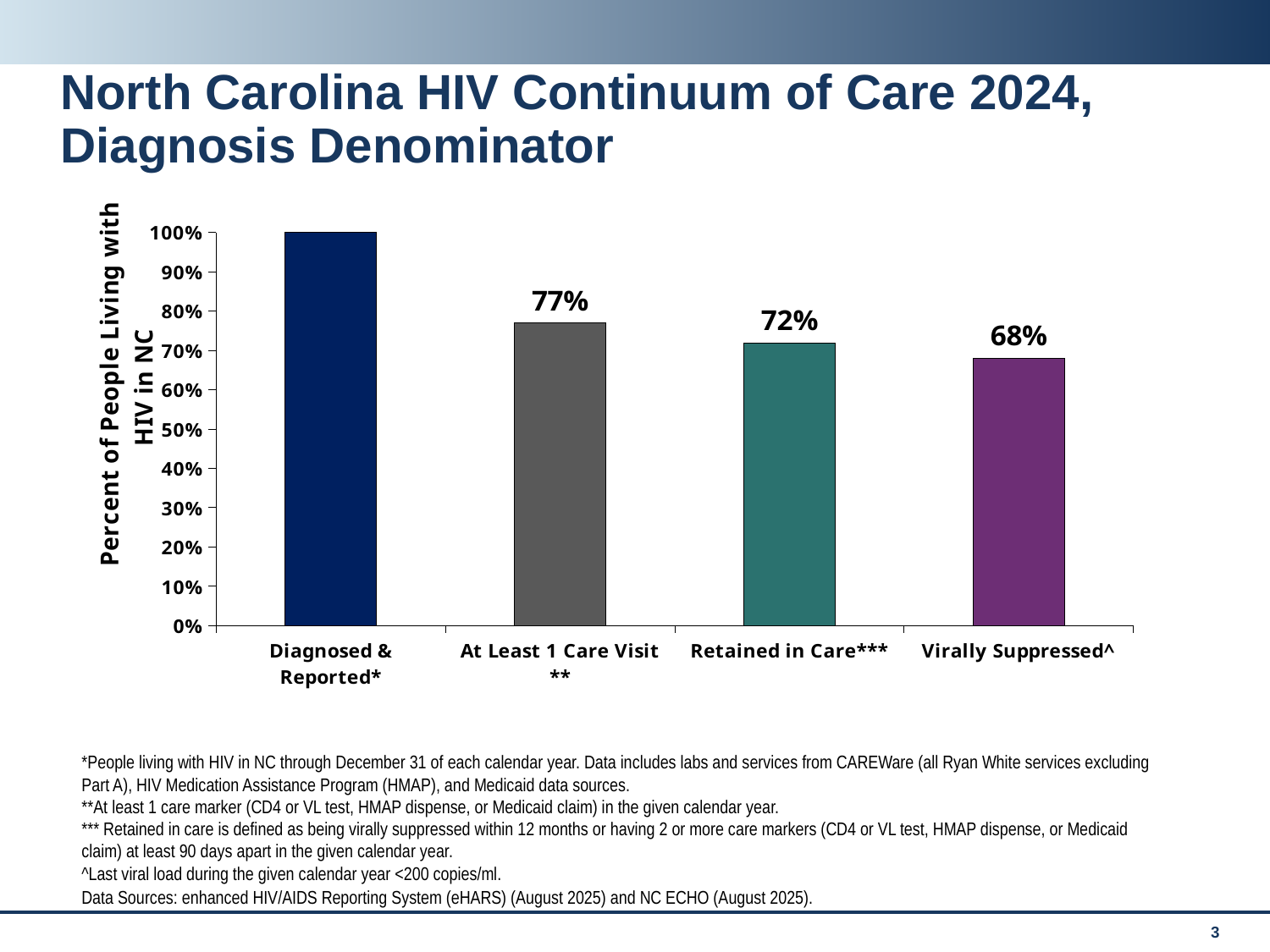
Which category has the lowest value? Virally Suppressed^ What is the value for Virally Suppressed^? 68% What kind of chart is shown on the slide? Bar chart Which category has the highest value? Diagnosed & Reported* What is the value for Retained in Care***? 72% What is the difference between the values for Retained in Care*** and Virally Suppressed^? 4% What is the value for Diagnosed & Reported*? 100% What is the difference between the values for At Least 1 Care Visit** and Virally Suppressed^? 9% How many categories are shown on the x axis? 4 What is the value for At Least 1 Care Visit**? 77% Which is larger, the value for At Least 1 Care Visit** or the value for Retained in Care***? At Least 1 Care Visit** Do the values rise or fall from left to right along the x axis? Fall